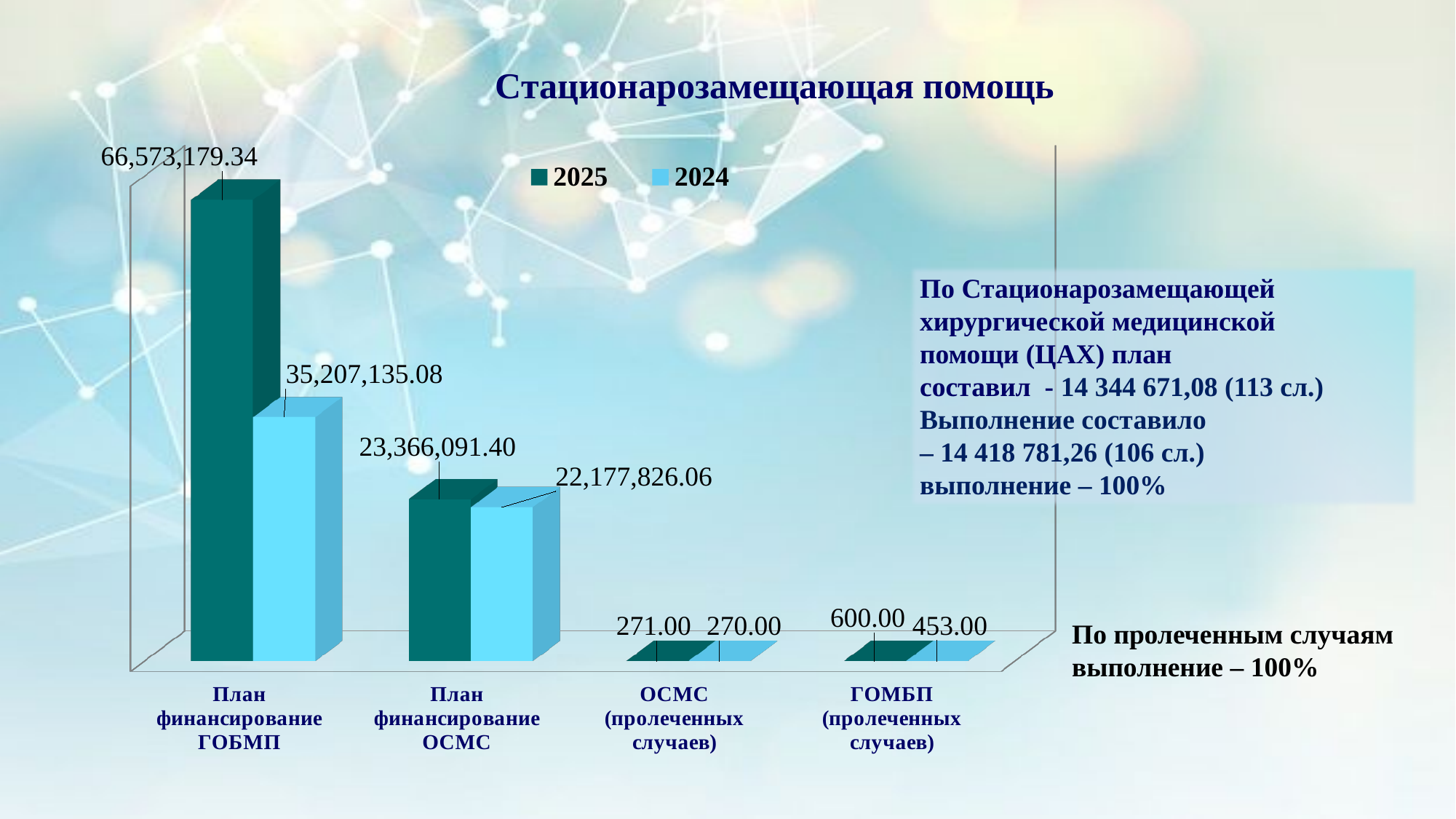
What is the 2025 value for План финансирование ГОБМП? 66,573,179.34 Which category has the highest 2025 value? План финансирование ГОБМП What is the 2025 value for План финансирование ОСМС? 23,366,091.40 What is the 2025 value for ОСМС (пролеченных случаев)? 271.00 What is the 2024 value for План финансирование ГОБМП? 35,207,135.08 How many series does the legend list? 2 What is the difference between the 2025 and 2024 values for План финансирование ГОБМП? 31,366,044.26 Which is larger for План финансирование ОСМС: the 2025 value or the 2024 value? 2025 Which category has the lowest 2024 value? ОСМС (пролеченных случаев) What is the difference between the 2025 and 2024 values for ГОМБП (пролеченных случаев)? 147.00 What is the 2024 value for ГОМБП (пролеченных случаев)? 453.00 How many categories are shown on the x axis? 4